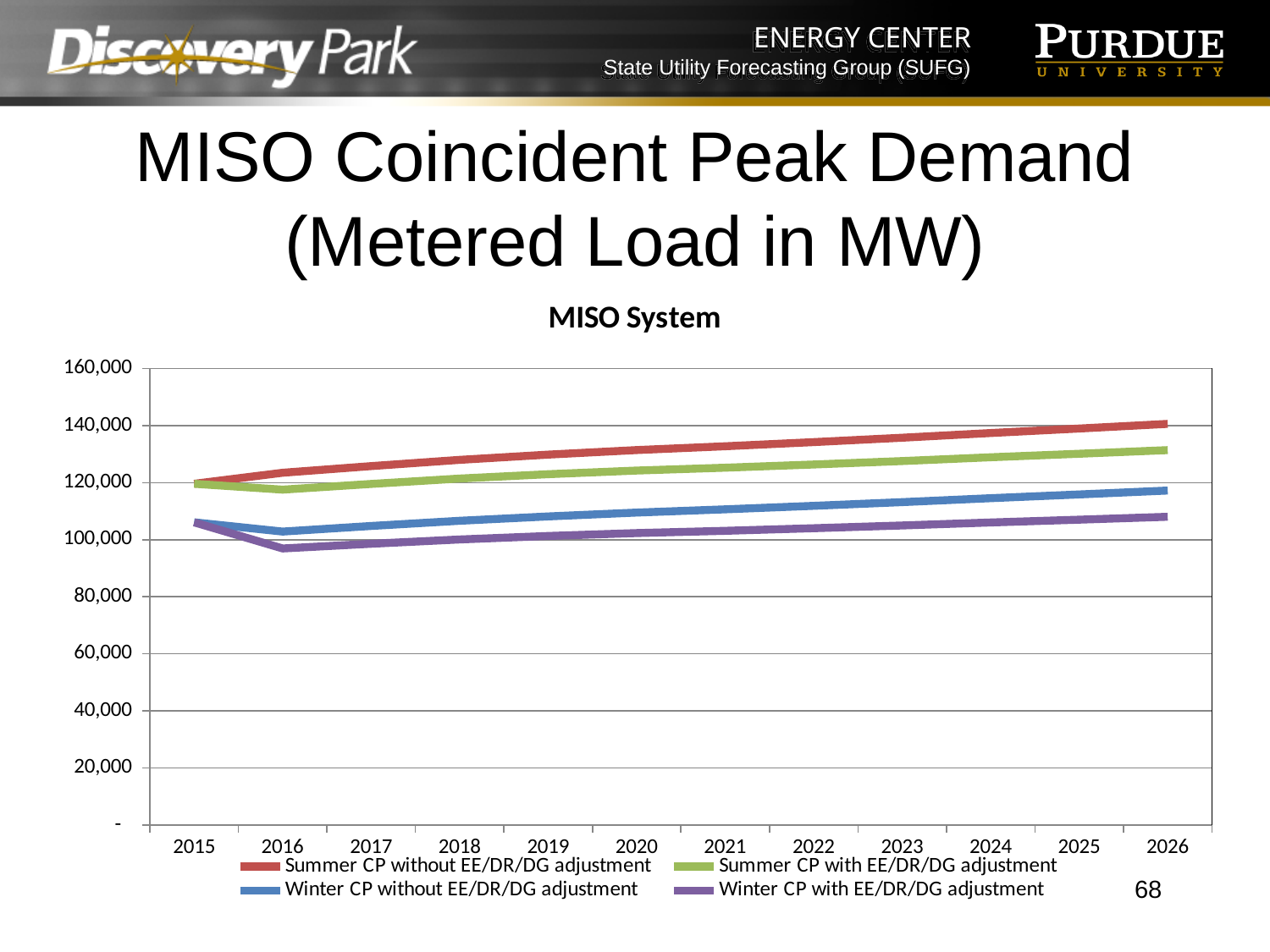
Which series is lowest in 2026? Winter CP with EE/DR/DG adjustment In 2026, which is larger: Summer CP without EE/DR/DG adjustment or Summer CP with EE/DR/DG adjustment? Summer CP without EE/DR/DG adjustment Is the value for Winter CP without EE/DR/DG adjustment in 2026 greater or less than 100,000? greater How many series does the legend list? 4 Does the Summer CP without EE/DR/DG adjustment series rise or fall from 2015 to 2026? Rise Is the value for Summer CP without EE/DR/DG adjustment in 2026 greater or less than 120,000? greater How many years are shown along the x axis? 12 Which series is highest in 2026? Summer CP without EE/DR/DG adjustment Is the value for Winter CP with EE/DR/DG adjustment in 2016 greater or less than 100,000? less What is the title of the chart? MISO System What colour is the line for Winter CP with EE/DR/DG adjustment? Purple What kind of chart is shown on the slide? Line chart